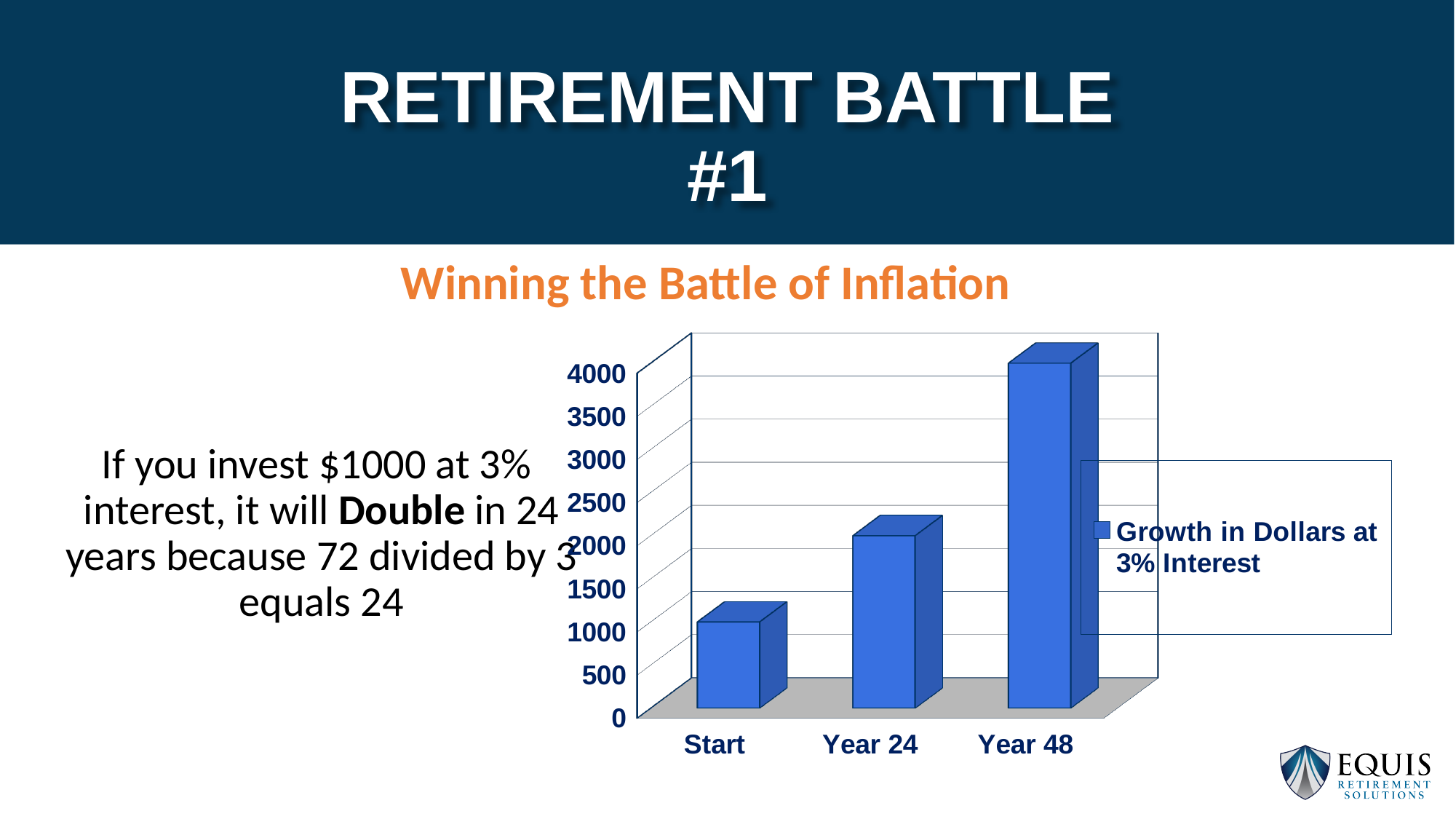
Is the value for Year 48 greater or less than 3500? greater How many categories are shown on the x axis of the chart? 3 What are the category labels on the x axis of the chart, from left to right? Start, Year 24, Year 48 Which category has the highest bar in the chart? Year 48 Is the value for Year 24 greater or less than 1500? greater What kind of chart is shown on the slide? bar chart Do the values rise or fall from Start to Year 48 along the x axis? rise Which is larger, the value for Year 24 or the value for Start? Year 24 Which category has the lowest bar in the chart? Start What is the legend entry for the series in the chart? Growth in Dollars at 3% Interest How many series does the chart legend list? 1 Is the value for Start greater or less than 1500? less